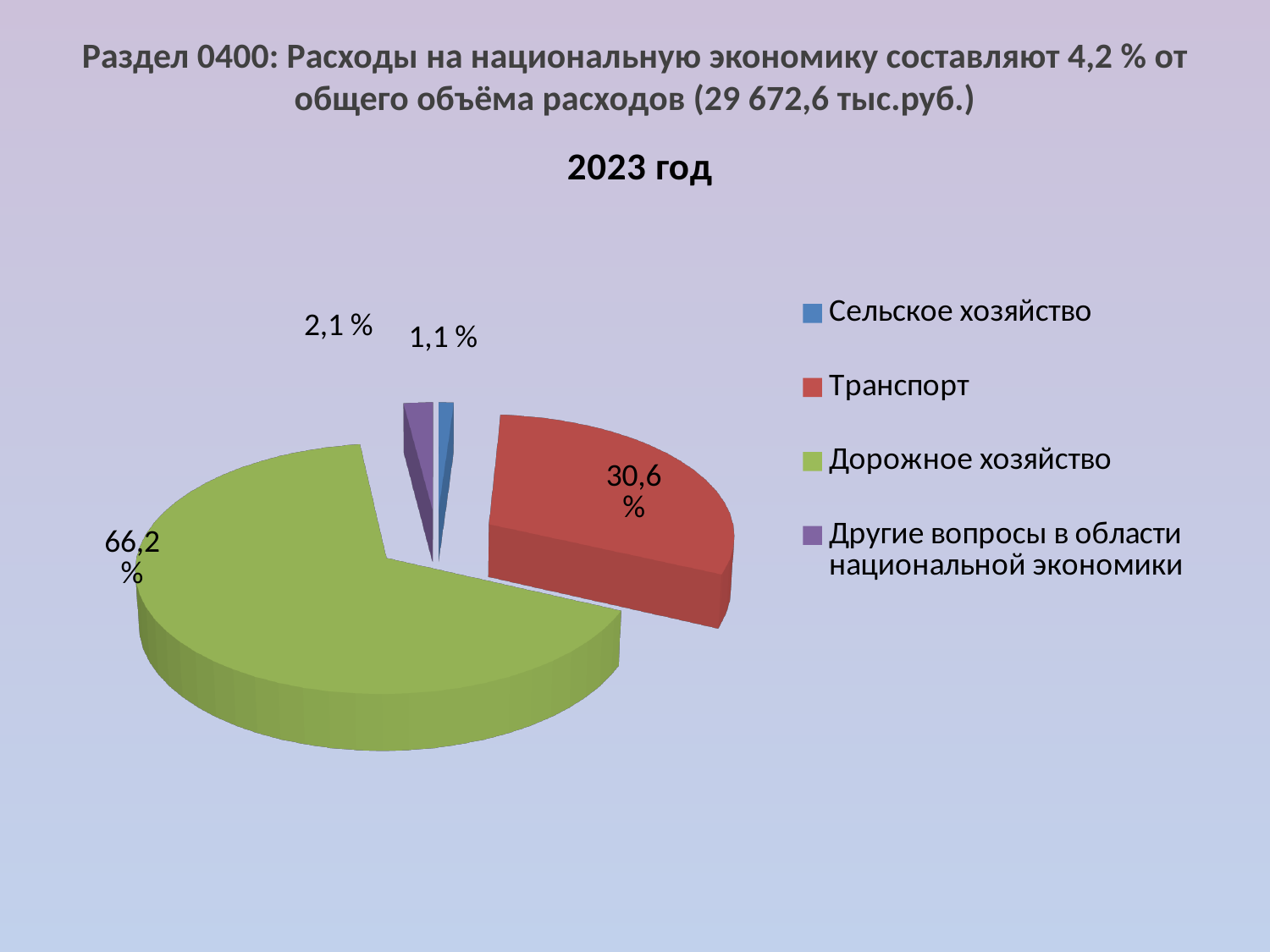
What colour is the slice for Транспорт in the pie chart? Red What is the share of Другие вопросы в области национальной экономики in the pie chart? 2,1 % What kind of chart is shown on the slide? Pie chart What is the difference in percentage points between Дорожное хозяйство and Транспорт? 35,6 What is the share of Транспорт in the pie chart? 30,6 % What is the share of Сельское хозяйство in the pie chart? 1,1 % What is the share of Дорожное хозяйство in the pie chart? 66,2 % Which is larger: the share of Транспорт or the share of Дорожное хозяйство? Дорожное хозяйство Which category has the largest slice of the pie chart? Дорожное хозяйство Which category has the smallest slice of the pie chart? Сельское хозяйство How many categories does the pie chart show? 4 What year is shown above the pie chart? 2023 год